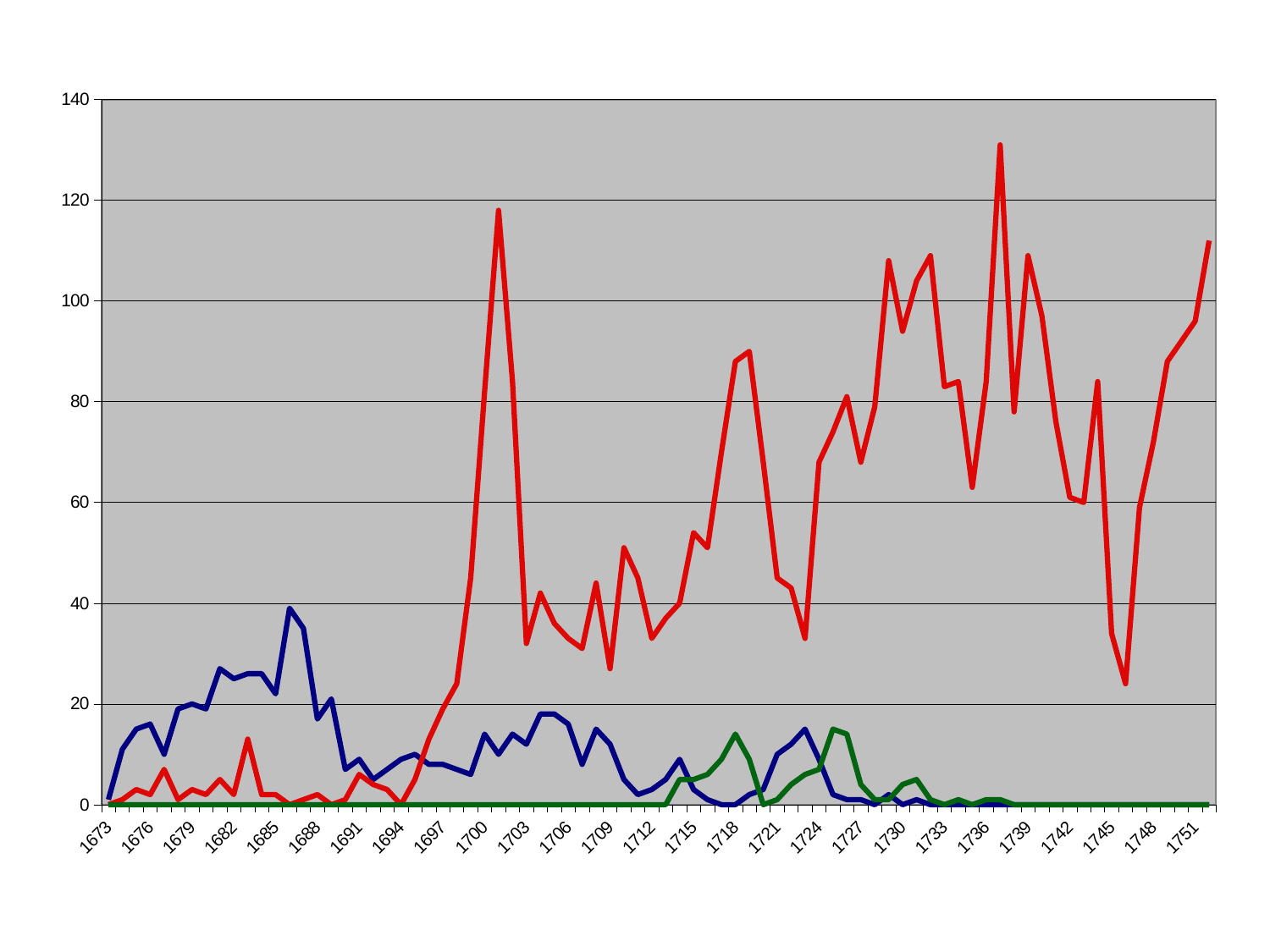
Is the value of the green line at 1718 greater or less than 20? less Is the value of the blue line at 1676 greater or less than 20? less What kind of chart is shown on the slide? line chart At 1700, which line has the higher value, the red line or the blue line? red Which coloured line reaches the highest value on the chart? red Is the value of the red line at 1697 greater or less than 40? less What is the highest value shown on the vertical axis? 140 Does the red line generally rise or fall from 1673 to 1751? rise At 1679, which line has the higher value, the blue line or the red line? blue How many lines are plotted on the chart? 3